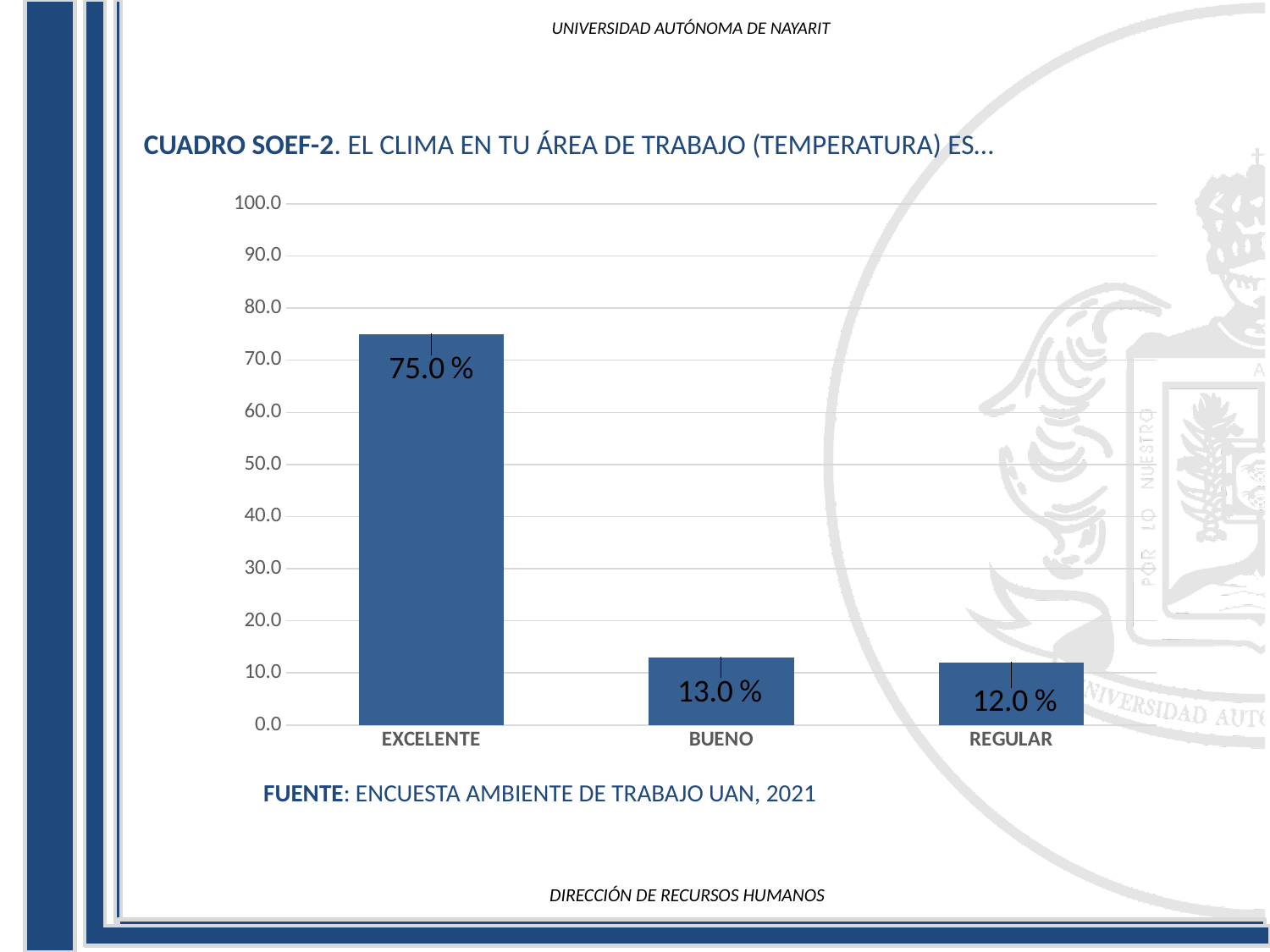
How many categories are shown on the x axis? 3 What kind of chart is shown on the slide? bar chart Which category has the highest value? EXCELENTE Is the value for EXCELENTE greater or less than 70.0? greater What is the difference between the values for BUENO and REGULAR? 1.0 % Which is larger, the value for EXCELENTE or the value for REGULAR? EXCELENTE What is the source cited below the chart? ENCUESTA AMBIENTE DE TRABAJO UAN, 2021 What is the value for REGULAR? 12.0 % Which category has the lowest value? REGULAR What is the value for EXCELENTE? 75.0 % What is the difference between the values for EXCELENTE and BUENO? 62.0 % What is the value for BUENO? 13.0 %